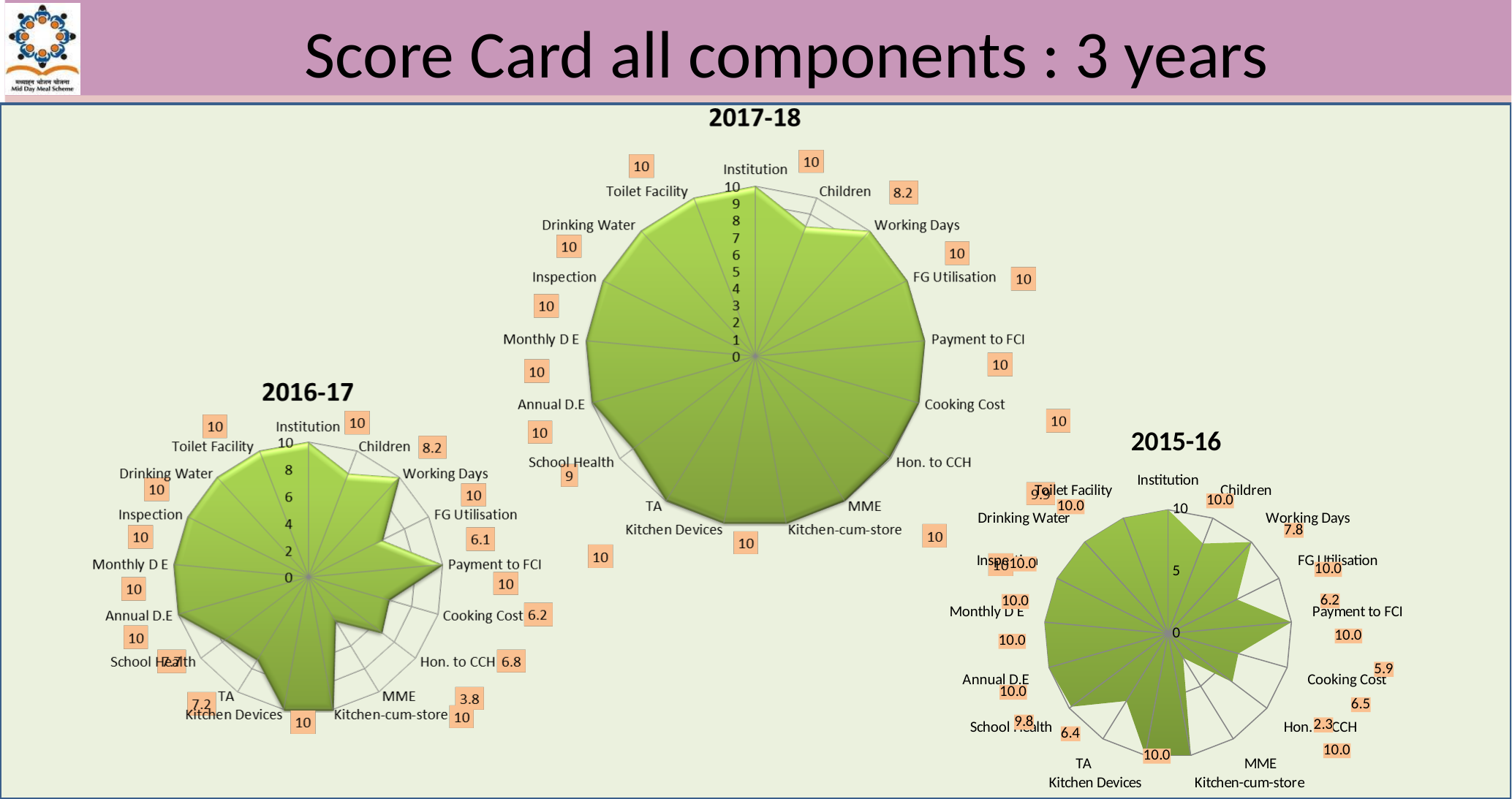
In the 2016-17 chart, what is the score for Hon. to CCH? 6.8 In the 2017-18 chart, which component has the lowest score? Children In the 2016-17 chart, which component has the lowest score? MME In the 2016-17 chart, which is larger, the score for Hon. to CCH or the score for MME? Hon. to CCH In the 2017-18 chart, what is the difference between the Institution score and the Children score? 1.8 In the 2016-17 chart, what is the score for MME? 3.8 In the 2016-17 chart, what is the score for FG Utilisation? 6.1 How many components are plotted in the 2017-18 chart? 17 How many charts are shown on the slide? 3 In the 2017-18 chart, what is the score for School Health? 9 What type of chart is used for the 2017-18 score card? Radar chart In the 2017-18 chart, what is the score for Children? 8.2